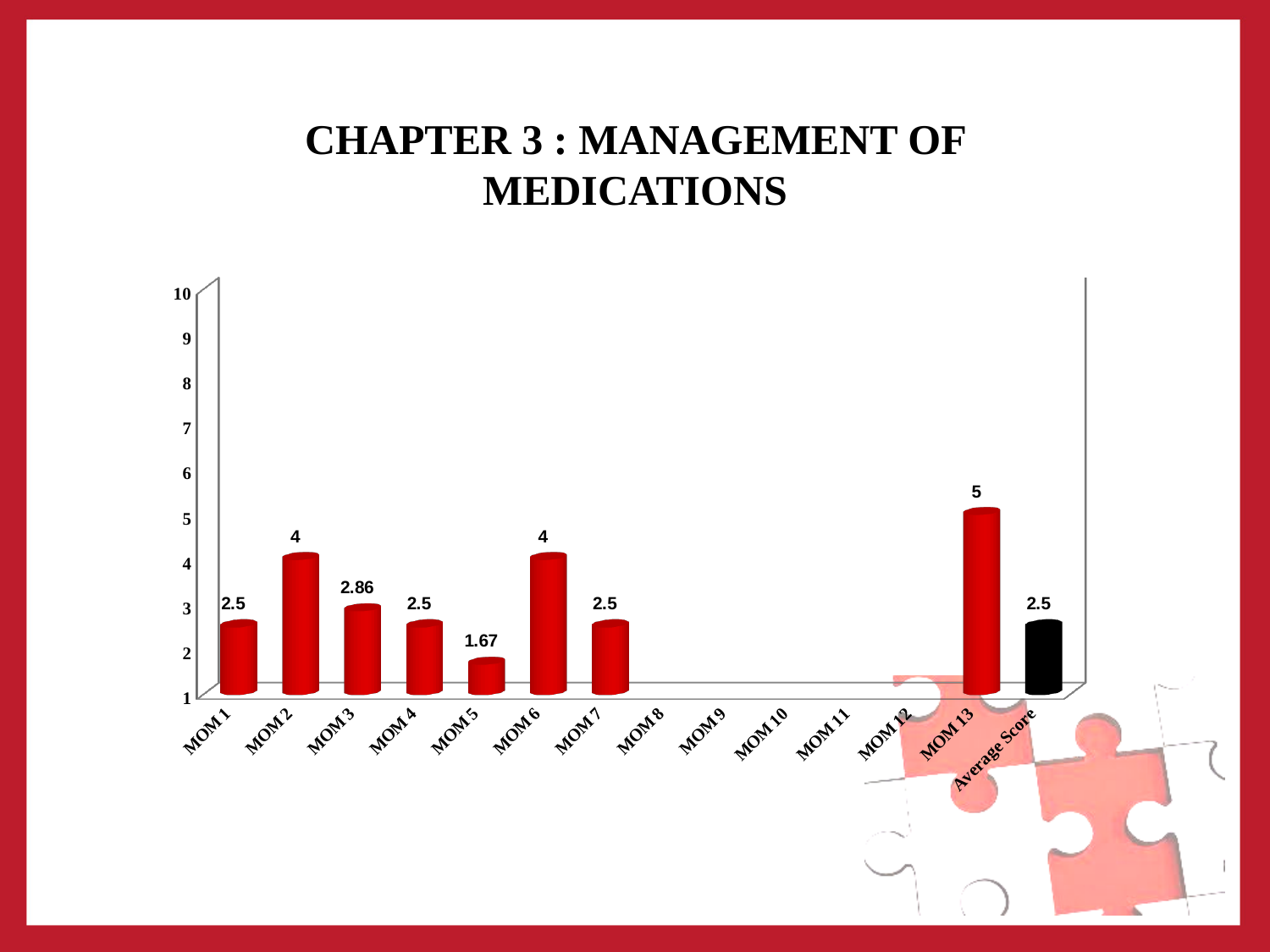
Among the categories with a plotted bar, which has the lowest value? MOM 5 Which is larger, the value for MOM 6 or the value for MOM 7? MOM 6 How many categories are labelled on the x axis? 14 What is the difference between the values for MOM 2 and MOM 3? 1.14 What kind of chart is shown on the slide? Bar chart What is the difference between the values for MOM 13 and MOM 5? 3.33 What is the value for MOM 3? 2.86 What is the Average Score shown on the chart? 2.5 What is the value for MOM 13? 5 What is the title of the slide containing the chart? CHAPTER 3 : MANAGEMENT OF MEDICATIONS What is the value for MOM 5? 1.67 Which category has the highest value? MOM 13